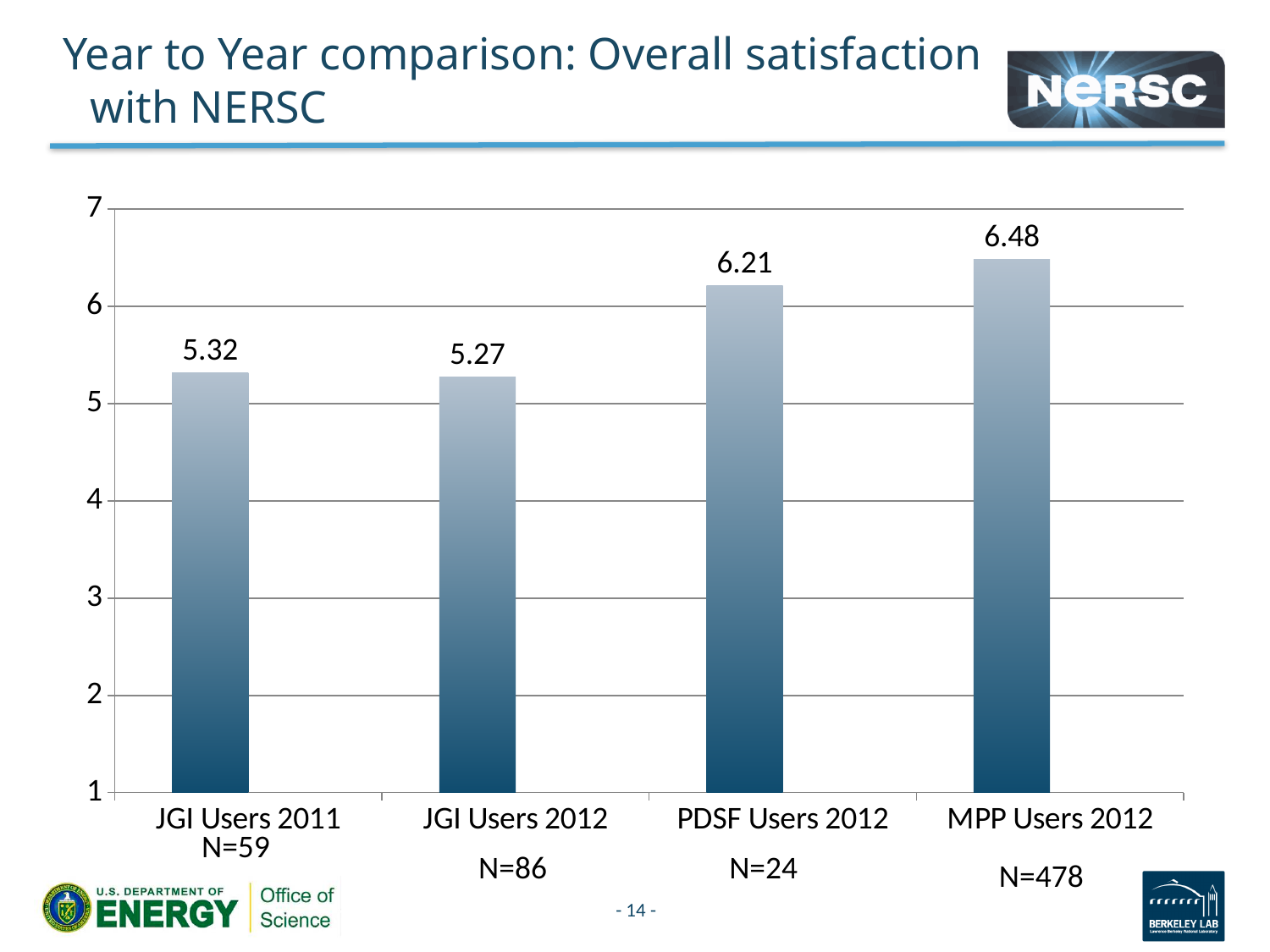
Is the value for PDSF Users 2012 greater or less than 6? greater What is the N value shown for MPP Users 2012? N=478 Which category has the highest overall satisfaction value? MPP Users 2012 What is the overall satisfaction value for JGI Users 2011? 5.32 Which category has the lowest overall satisfaction value? JGI Users 2012 What is the difference between the values for MPP Users 2012 and PDSF Users 2012? 0.27 What is the overall satisfaction value for PDSF Users 2012? 6.21 Which is larger, the value for PDSF Users 2012 or the value for JGI Users 2012? PDSF Users 2012 What is the difference between the values for JGI Users 2011 and JGI Users 2012? 0.05 How many categories are shown on the chart? 4 What is the overall satisfaction value for MPP Users 2012? 6.48 What kind of chart is shown on the slide? bar chart